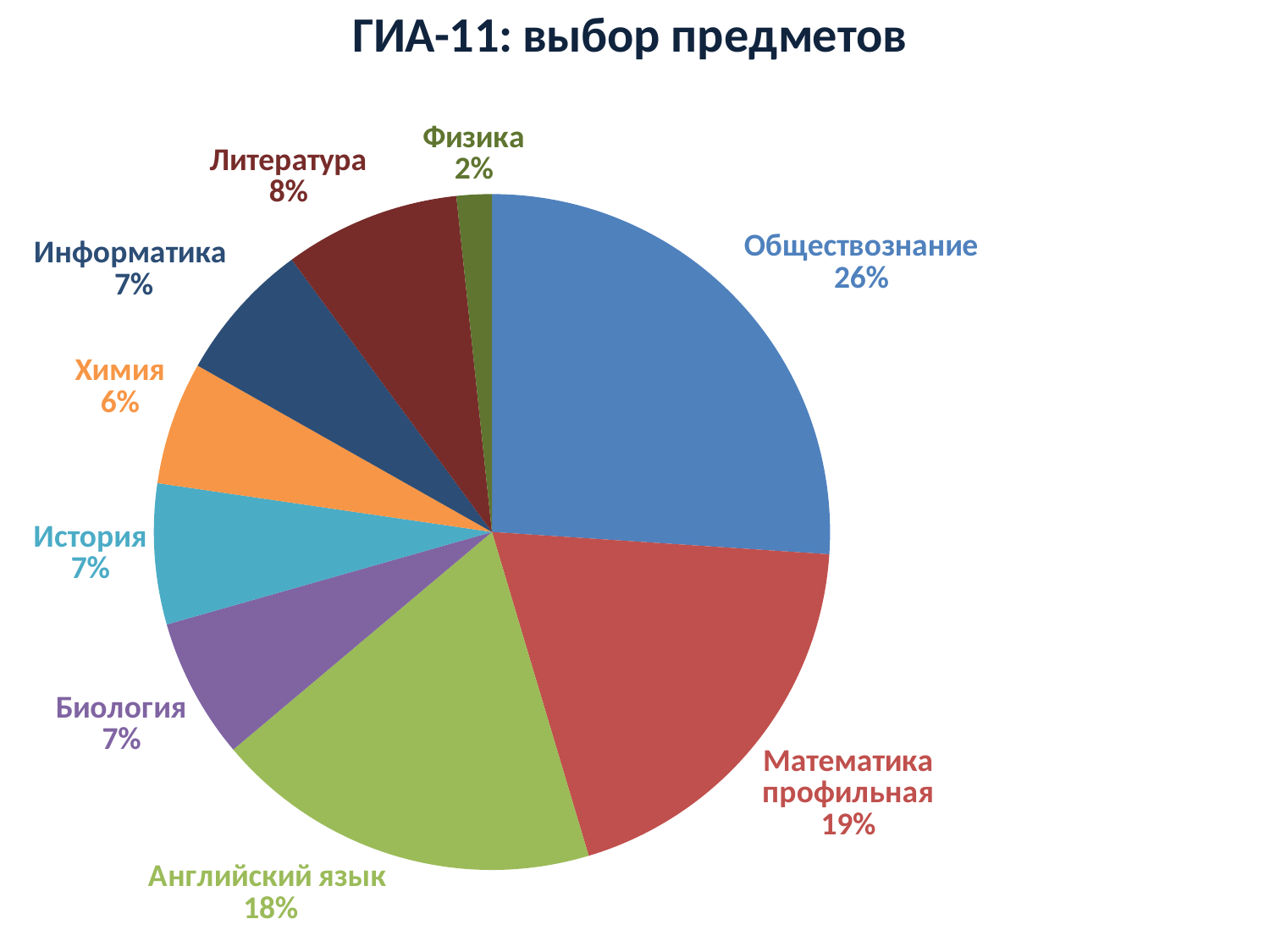
What is the value shown for Английский язык? 18% What is the value shown for Химия? 6% Which is larger, the share for Английский язык or the share for Литература? Английский язык What is the title of the chart? ГИА-11: выбор предметов What is the difference in percentage points between Литература and Физика? 6 Which subject has the largest slice of the pie? Обществознание What is the value shown for Математика профильная? 19% What is the difference in percentage points between Обществознание and Математика профильная? 7 What kind of chart is shown on the slide? Pie chart How many subjects (slices) are shown in the pie chart? 9 What share of the pie does Обществознание have? 26% Which subject has the smallest slice of the pie? Физика